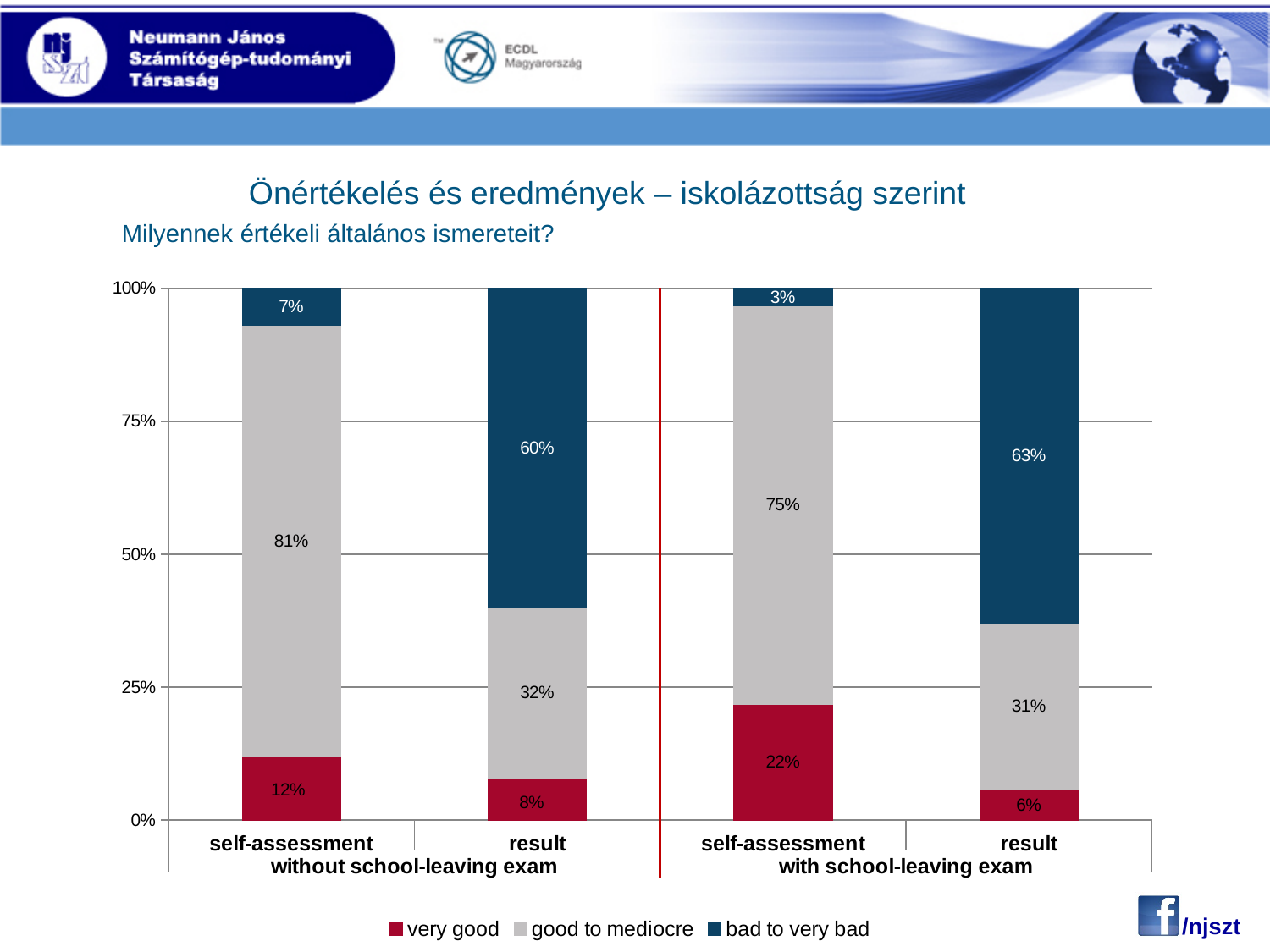
What is the 'good to mediocre' value for self-assessment with school-leaving exam? 75% What is the difference between the 'good to mediocre' values for self-assessment and result without school-leaving exam? 49% Which is larger: the 'bad to very bad' value for result without school-leaving exam or for result with school-leaving exam? result with school-leaving exam Which bar has the lowest 'bad to very bad' value? self-assessment with school-leaving exam What kind of chart is shown on the slide? stacked bar chart Which legend entry is shown in red? very good What is the 'bad to very bad' value for result with school-leaving exam? 63% How many series does the legend list? 3 What is the 'very good' value for self-assessment without school-leaving exam? 12% Which bar has the highest 'very good' value? self-assessment with school-leaving exam What is the 'bad to very bad' value for self-assessment with school-leaving exam? 3% How many bars are plotted in the chart? 4